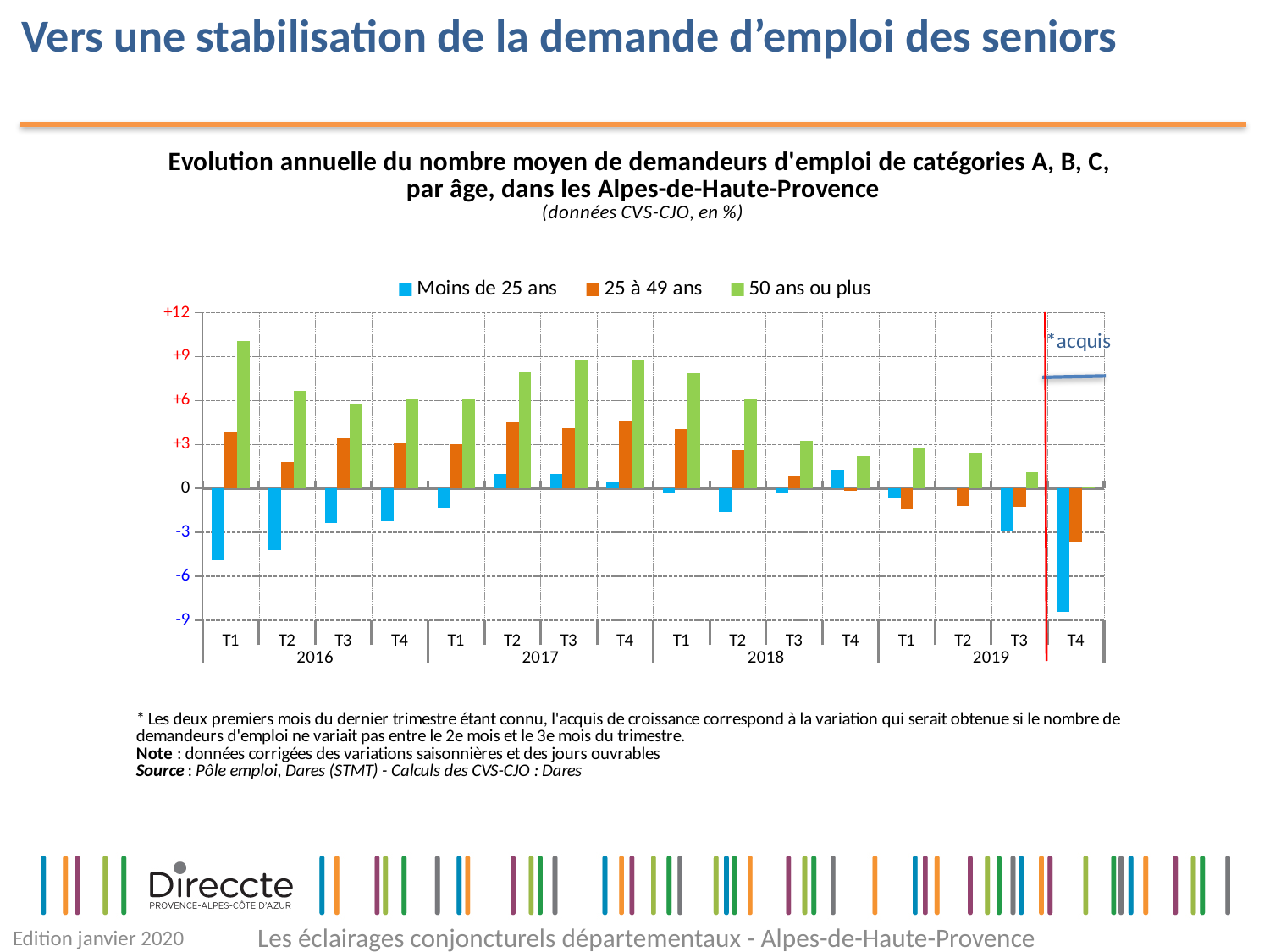
What kind of chart is shown on the slide? bar chart How many series does the legend list? 3 Does the value for '50 ans ou plus' rise or fall from T1 2018 to T4 2019? fall In T1 2016, which series has the larger value: '25 à 49 ans' or '50 ans ou plus'? 50 ans ou plus Which quarter has the highest value for the '50 ans ou plus' series? T1 2016 How many quarters are shown along the x axis? 16 Which quarter has the lowest value for the 'Moins de 25 ans' series? T4 2019 Is the value for 'Moins de 25 ans' in T4 2019 greater or less than -6? less Is the value for '25 à 49 ans' in T2 2017 greater or less than +3? greater Is the value for '50 ans ou plus' in T1 2016 greater or less than +9? greater Which legend entry is shown in green? 50 ans ou plus What label is written next to the red vertical line at the right of the chart? * acquis